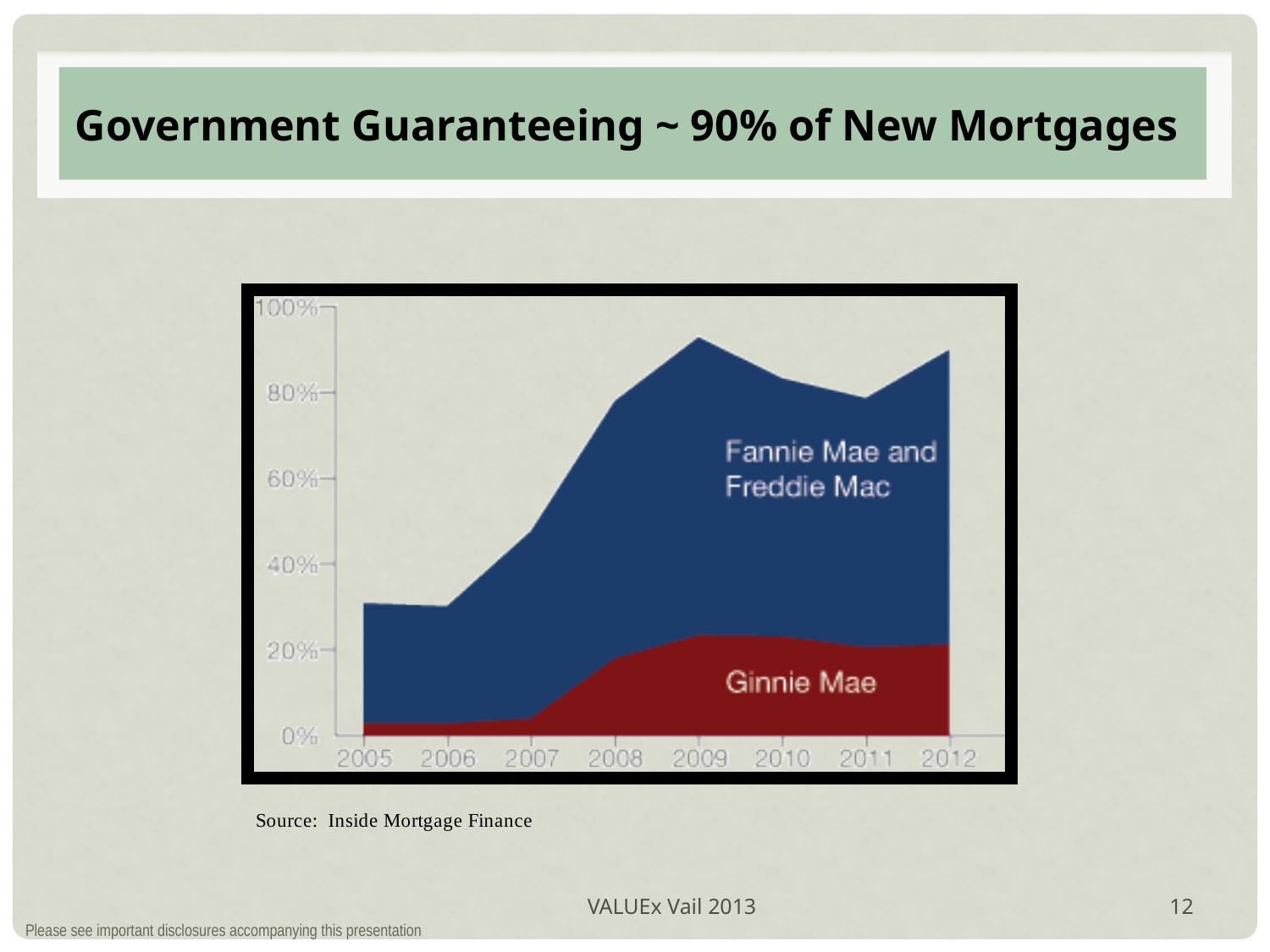
Is the combined value for Fannie Mae and Freddie Mac plus Ginnie Mae in 2006 greater or less than 40%? less Is the value for Ginnie Mae in 2007 greater or less than 20%? less Is the combined value for Fannie Mae and Freddie Mac plus Ginnie Mae in 2009 greater or less than 80%? greater How many years are shown along the x axis of the chart? 8 What kind of chart is shown on the slide? Stacked area chart Does the combined share of Fannie Mae and Freddie Mac plus Ginnie Mae rise or fall from 2005 to 2009? rise In which year does the combined share of Fannie Mae and Freddie Mac plus Ginnie Mae reach its highest point? 2009 What is the source cited below the chart? Inside Mortgage Finance Which series is shown in red on the chart? Ginnie Mae How many series does the chart show? 2